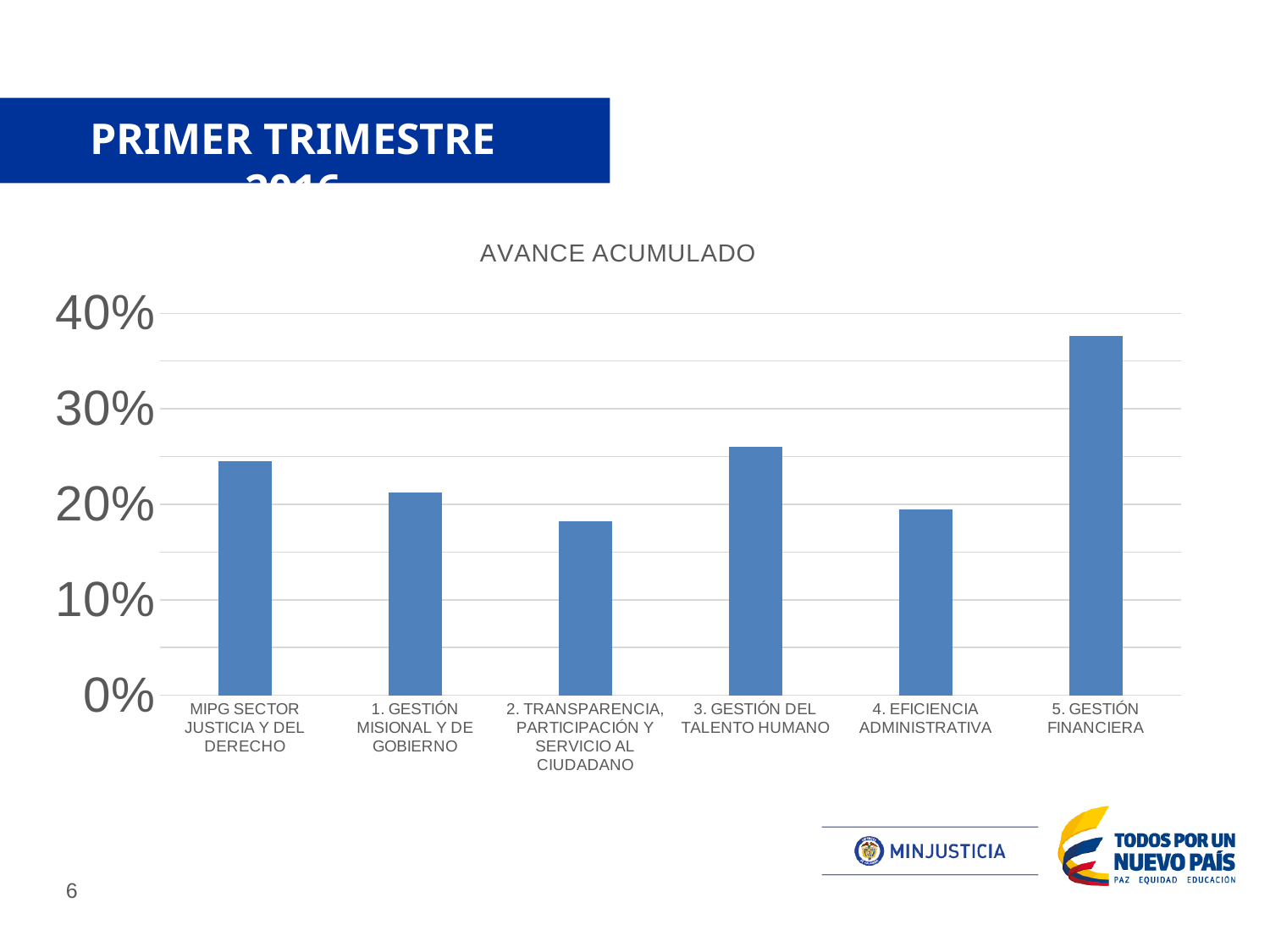
Which category has the highest value in the chart? 5. GESTIÓN FINANCIERA Which is larger, the value for 3. GESTIÓN DEL TALENTO HUMANO or the value for 1. GESTIÓN MISIONAL Y DE GOBIERNO? 3. GESTIÓN DEL TALENTO HUMANO What kind of chart is shown on the slide? bar chart How many categories are plotted in the chart? 6 What colour are the bars in the chart? blue Is the value for 3. GESTIÓN DEL TALENTO HUMANO greater or less than 30%? less Is the value for 2. TRANSPARENCIA, PARTICIPACIÓN Y SERVICIO AL CIUDADANO greater or less than 20%? less Is the value for 5. GESTIÓN FINANCIERA greater or less than 40%? less Which is larger, the value for MIPG SECTOR JUSTICIA Y DEL DERECHO or the value for 4. EFICIENCIA ADMINISTRATIVA? MIPG SECTOR JUSTICIA Y DEL DERECHO What is the title of the chart? AVANCE ACUMULADO